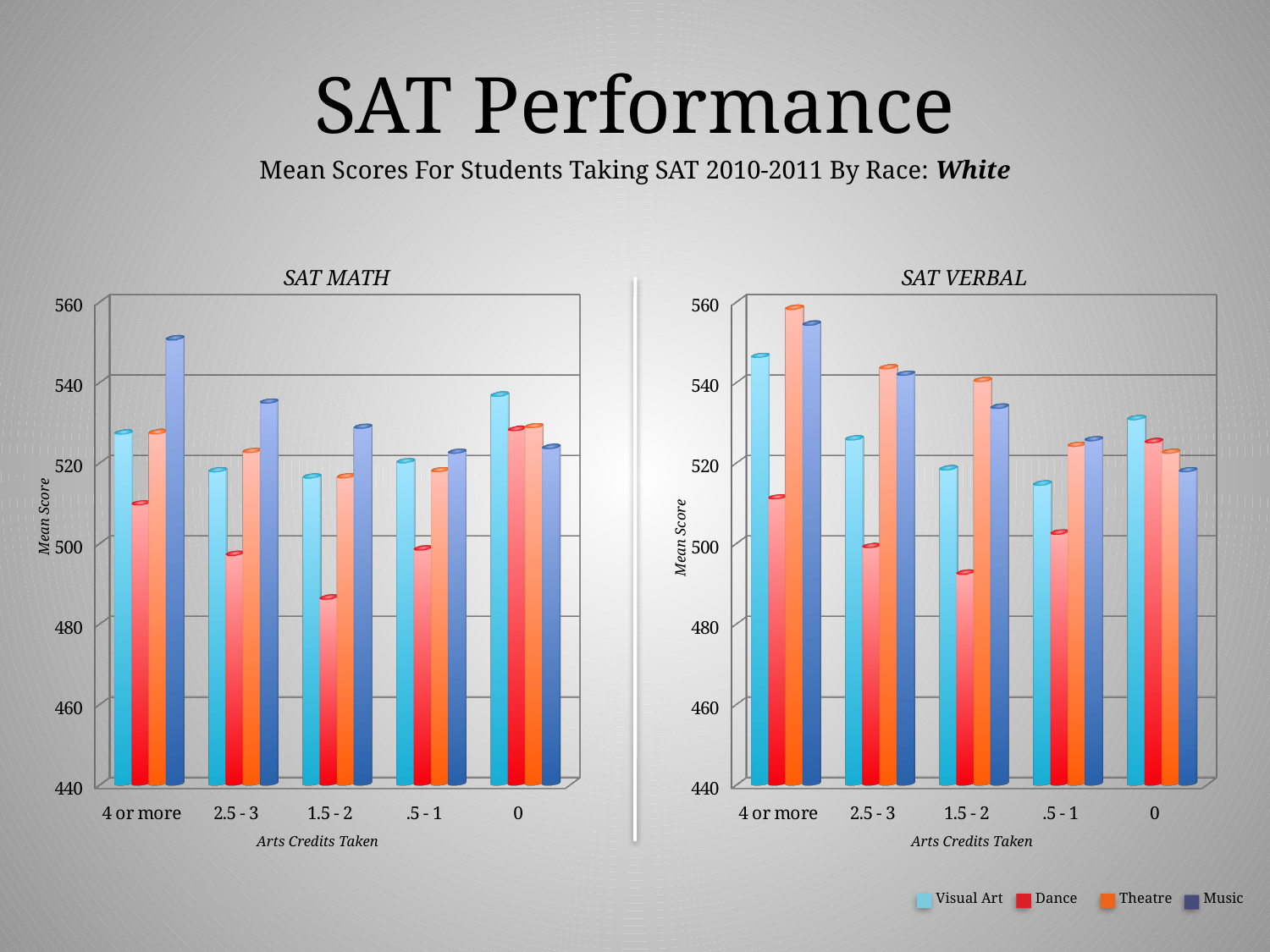
What is the x-axis title of the SAT VERBAL chart? Arts Credits Taken In the SAT MATH chart, is the value for Dance at '1.5 - 2' greater or less than 500? less How many arts-credit categories are shown on the x axis of the SAT VERBAL chart? 5 In the SAT VERBAL chart, which series has the lowest bar in the '1.5 - 2' category? Dance In the SAT VERBAL chart, is the value for Visual Art at '4 or more' greater or less than 540? greater In the SAT MATH chart, is the value for Music at '4 or more' greater or less than 540? greater In the SAT MATH chart, which series has the lowest bar in the '1.5 - 2' category? Dance In the SAT MATH chart, which series has the highest bar in the '4 or more' category? Music How many series does the legend list for the charts? 4 In the SAT VERBAL chart, for the '2.5 - 3' category, which is larger: Theatre or Dance? Theatre In the SAT MATH chart, for the '0' category, which is larger: Visual Art or Dance? Visual Art What kind of chart is the SAT MATH chart? bar chart